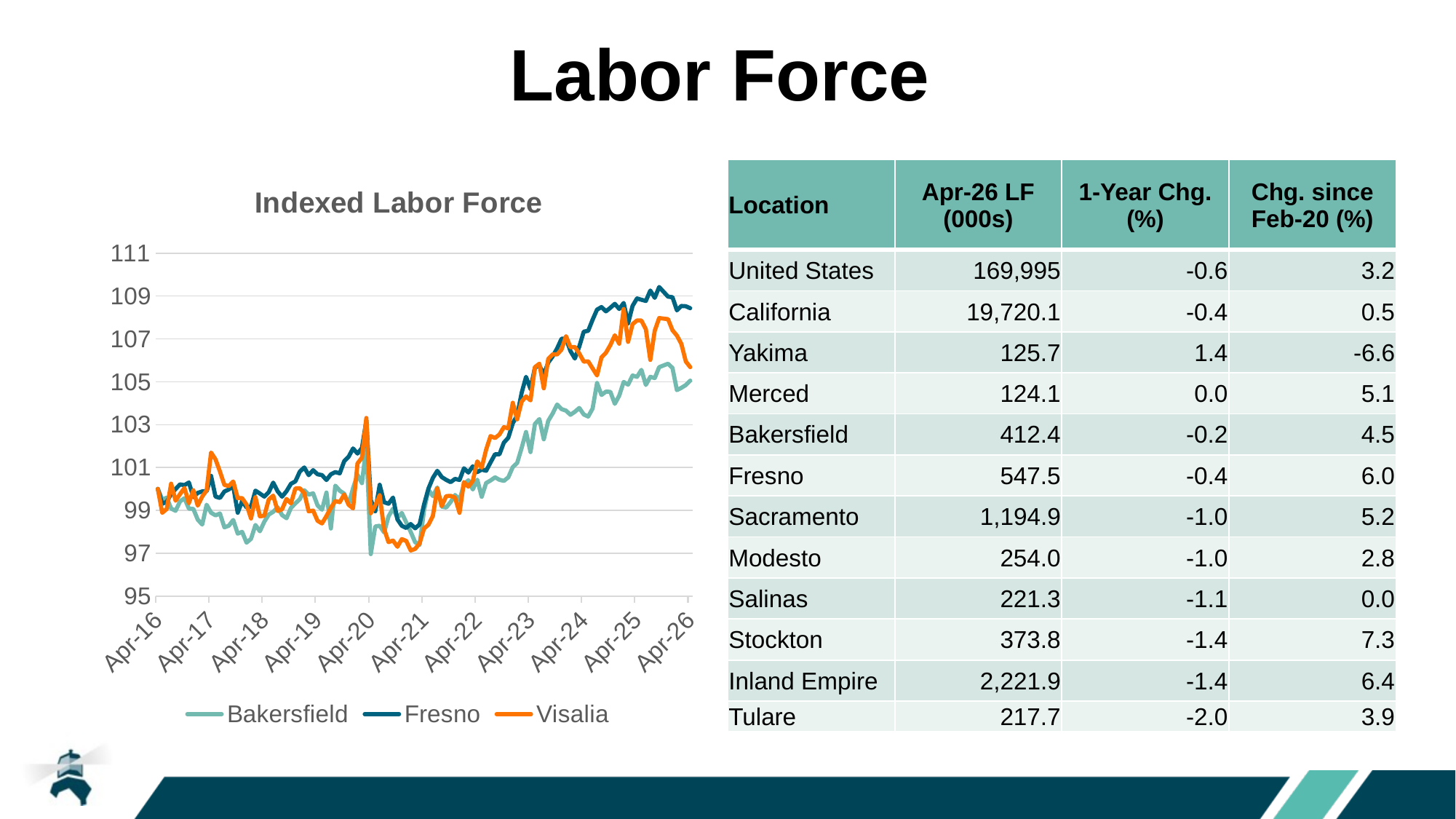
In the Indexed Labor Force chart, is the value for Bakersfield at Apr-22 greater or less than 103? less In the Indexed Labor Force chart, which series is highest at Apr-26? Fresno In the Indexed Labor Force chart, is the value for Bakersfield at Apr-26 greater or less than 107? less Which series are shown in the legend of the Indexed Labor Force chart? Bakersfield, Fresno, Visalia In the Indexed Labor Force chart, is the value for Fresno at Apr-26 greater or less than 107? greater How many year labels are shown on the x axis of the Indexed Labor Force chart? 11 What kind of chart is the Indexed Labor Force chart? line chart In the Indexed Labor Force chart, which is higher at Apr-25, Fresno or Bakersfield? Fresno In the Indexed Labor Force chart, do the Fresno values rise or fall between Apr-21 and Apr-25? rise How many series does the legend of the Indexed Labor Force chart list? 3 What is the title of the chart on the slide? Indexed Labor Force